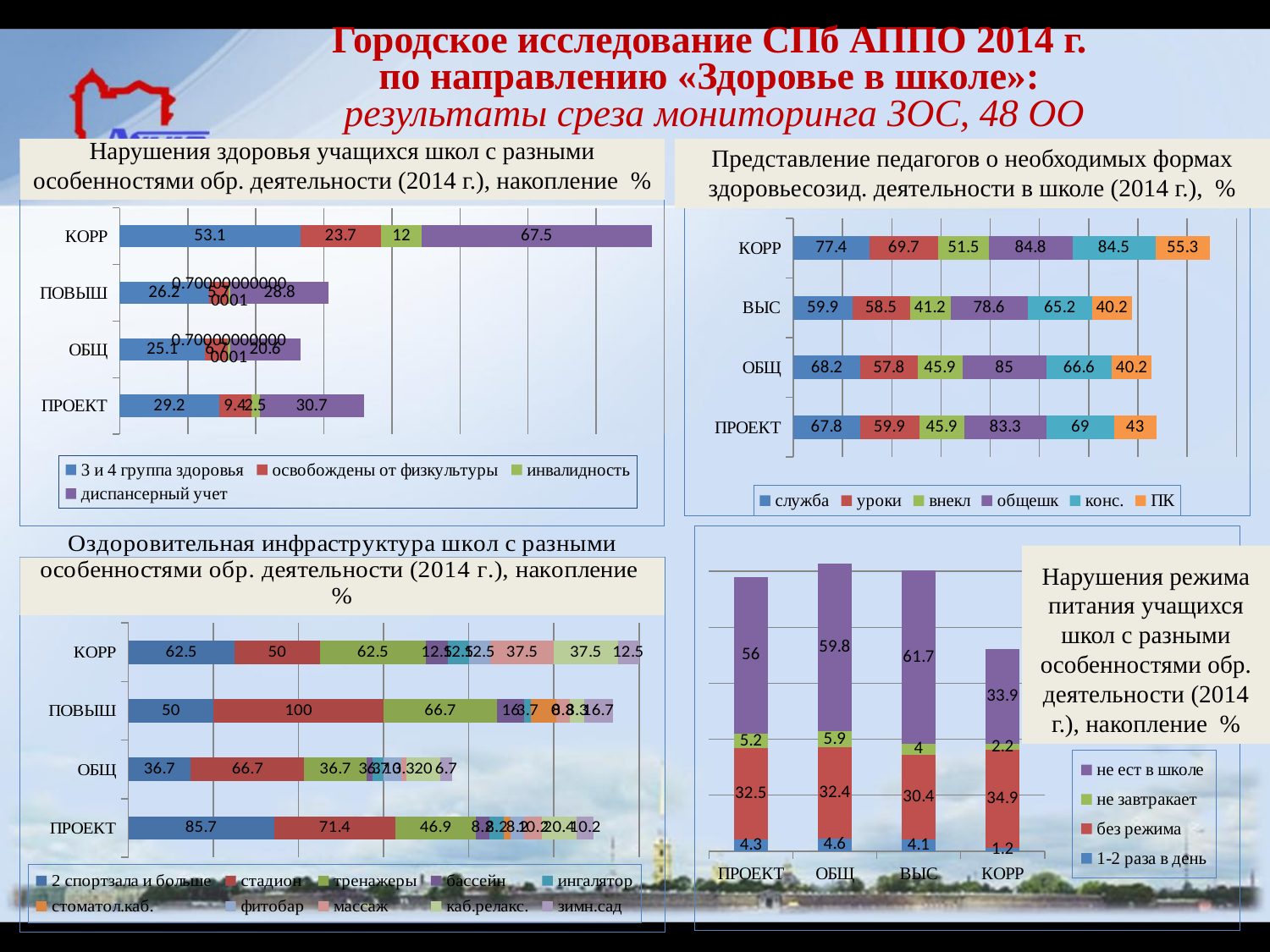
In the chart 'Нарушения здоровья учащихся школ с разными особенностями обр. деятельности', which category has the highest value for 'диспансерный учет'? КОРР In the chart 'Нарушения здоровья учащихся школ с разными особенностями обр. деятельности', what is the value of 'диспансерный учет' for ПРОЕКТ? 30.7 What kind of chart is 'Нарушения режима питания учащихся школ с разными особенностями обр. деятельности'? stacked bar chart In the chart 'Нарушения режима питания учащихся школ с разными особенностями обр. деятельности', which category has the lowest value for 'не ест в школе'? КОРР In the chart 'Нарушения режима питания учащихся школ с разными особенностями обр. деятельности', what is the total of the stacked bar for КОРР? 72.2 In the chart 'Представление педагогов о необходимых формах здоровьесозид. деятельности в школе', what is the value of 'общешк' for ОБЩ? 85 In the chart 'Оздоровительная инфраструктура школ с разными особенностями обр. деятельности', what is the value of 'стадион' for ПОВЫШ? 100 In the chart 'Нарушения здоровья учащихся школ с разными особенностями обр. деятельности', what is the value of '3 и 4 группа здоровья' for КОРР? 53.1 In the chart 'Оздоровительная инфраструктура школ с разными особенностями обр. деятельности', which category has the highest value for '2 спортзала и больше'? ПРОЕКТ In the chart 'Представление педагогов о необходимых формах здоровьесозид. деятельности в школе', which is larger: the 'ПК' value for ПРОЕКТ or for ВЫС? ПРОЕКТ How many series does the legend list in the chart 'Представление педагогов о необходимых формах здоровьесозид. деятельности в школе'? 6 In the chart 'Представление педагогов о необходимых формах здоровьесозид. деятельности в школе', what is the difference between the 'служба' values for КОРР and ВЫС? 17.5